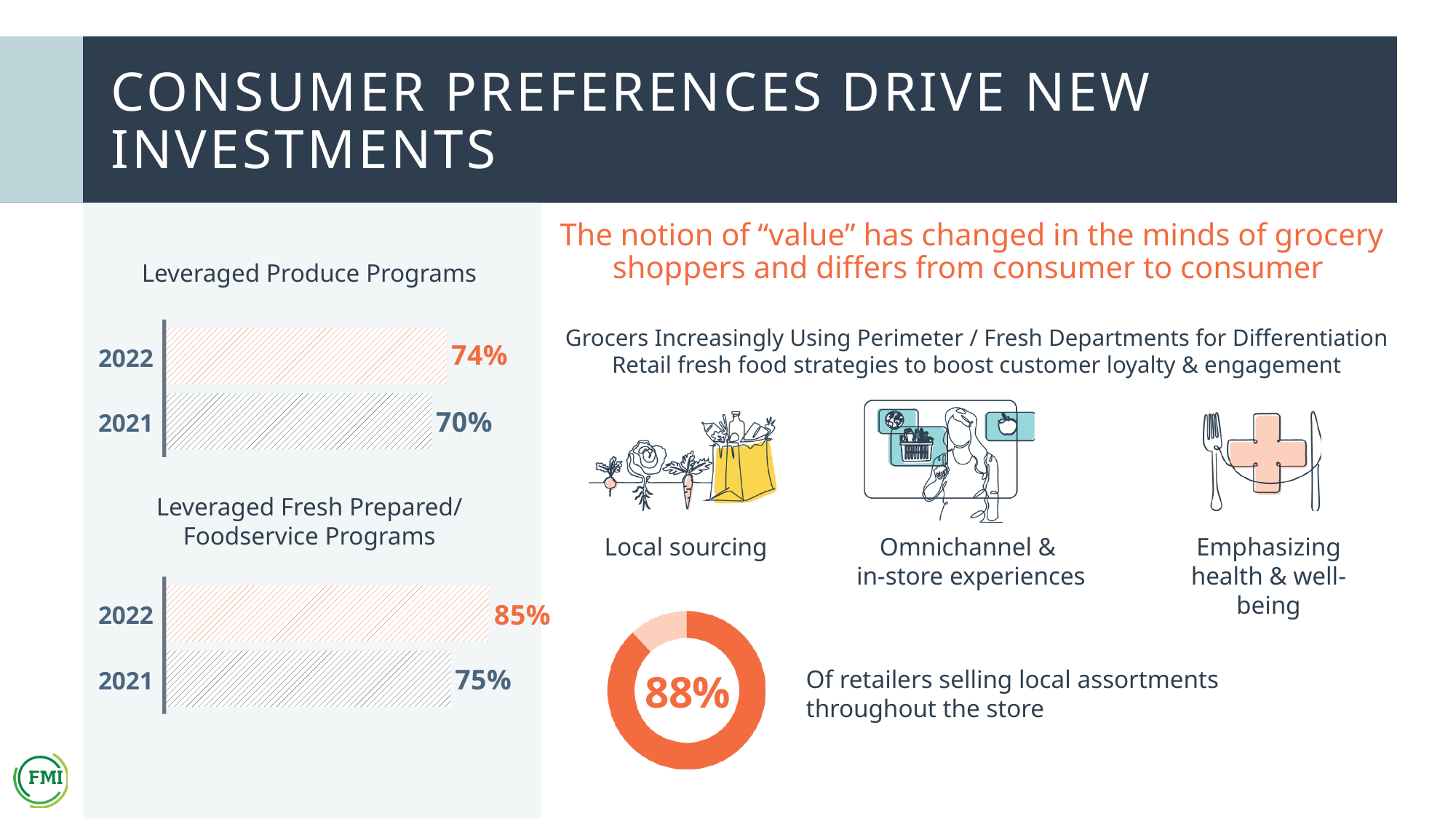
In the 'Leveraged Fresh Prepared/Foodservice Programs' chart, what is the value for 2021? 75% In the 'Leveraged Produce Programs' chart, what is the difference between the 2022 and 2021 values? 4% In the 'Leveraged Produce Programs' chart, what is the value for 2021? 70% What kind of chart is the 'Leveraged Produce Programs' chart? Bar chart In the 'Leveraged Fresh Prepared/Foodservice Programs' chart, what is the value for 2022? 85% What percentage is shown in the donut chart at the bottom right of the slide? 88% How many bars are in the 'Leveraged Fresh Prepared/Foodservice Programs' chart? 2 What does the 88% in the donut chart represent? Retailers selling local assortments throughout the store In the 'Leveraged Produce Programs' chart, which year has the lower value? 2021 In the 'Leveraged Produce Programs' chart, what is the value for 2022? 74% In the 'Leveraged Fresh Prepared/Foodservice Programs' chart, what is the difference between the 2022 and 2021 values? 10% In the 'Leveraged Fresh Prepared/Foodservice Programs' chart, which year has the higher value? 2022